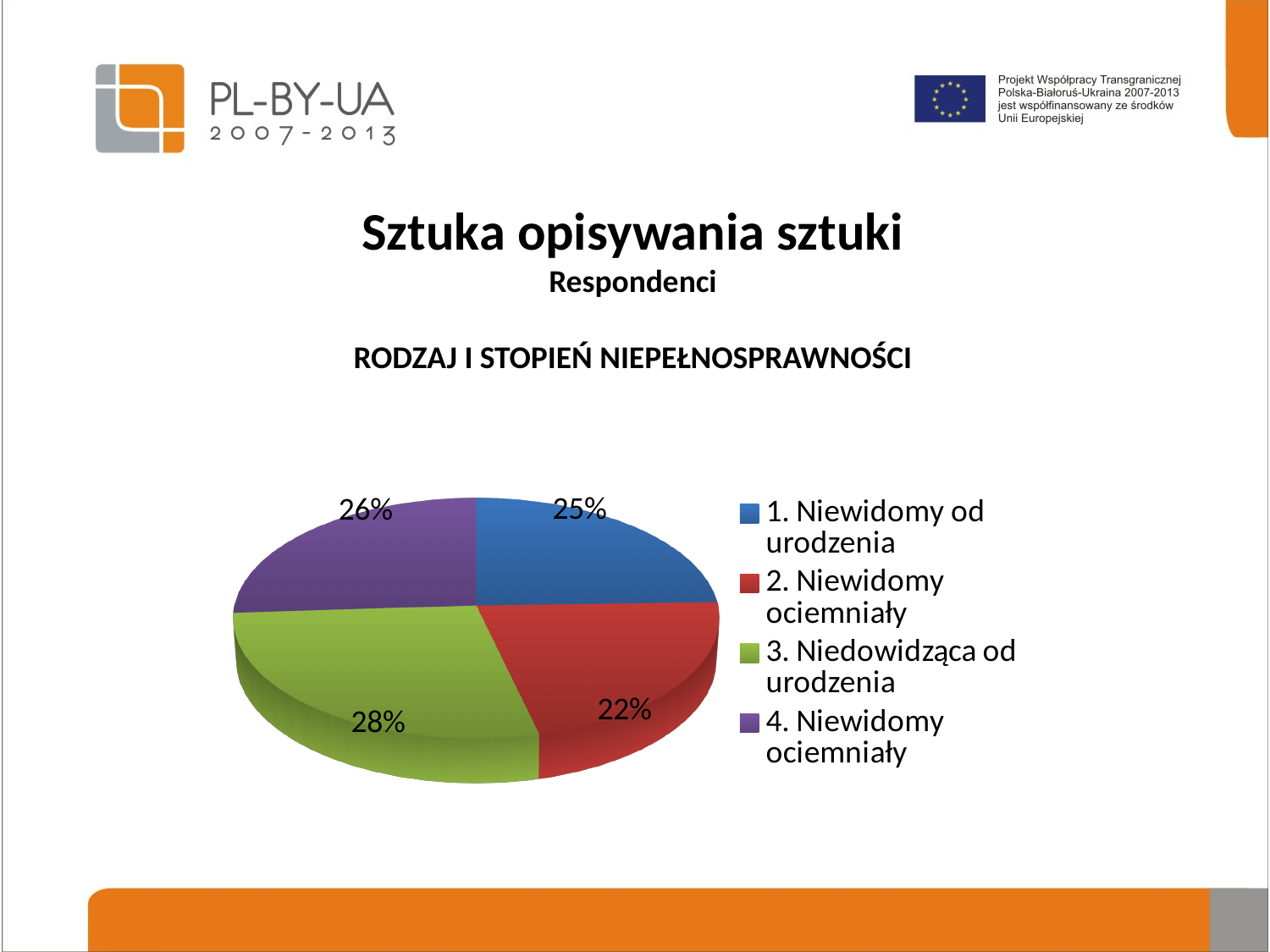
What kind of chart is shown on the slide? pie chart What share of the pie does "3. Niedowidząca od urodzenia" have? 28% Which category has the smallest slice of the pie? 2. Niewidomy ociemniały How many slices does the pie chart have? 4 How many entries does the legend list? 4 What share of the pie does "2. Niewidomy ociemniały" have? 22% What colour is the slice for "3. Niedowidząca od urodzenia"? green What share of the pie does "4. Niewidomy ociemniały" have? 26% Which is larger: the slice for "1. Niewidomy od urodzenia" or the slice for "4. Niewidomy ociemniały"? 4. Niewidomy ociemniały What share of the pie does "1. Niewidomy od urodzenia" have? 25% Which category has the largest slice of the pie? 3. Niedowidząca od urodzenia What is the difference in percentage points between "3. Niedowidząca od urodzenia" and "2. Niewidomy ociemniały"? 6